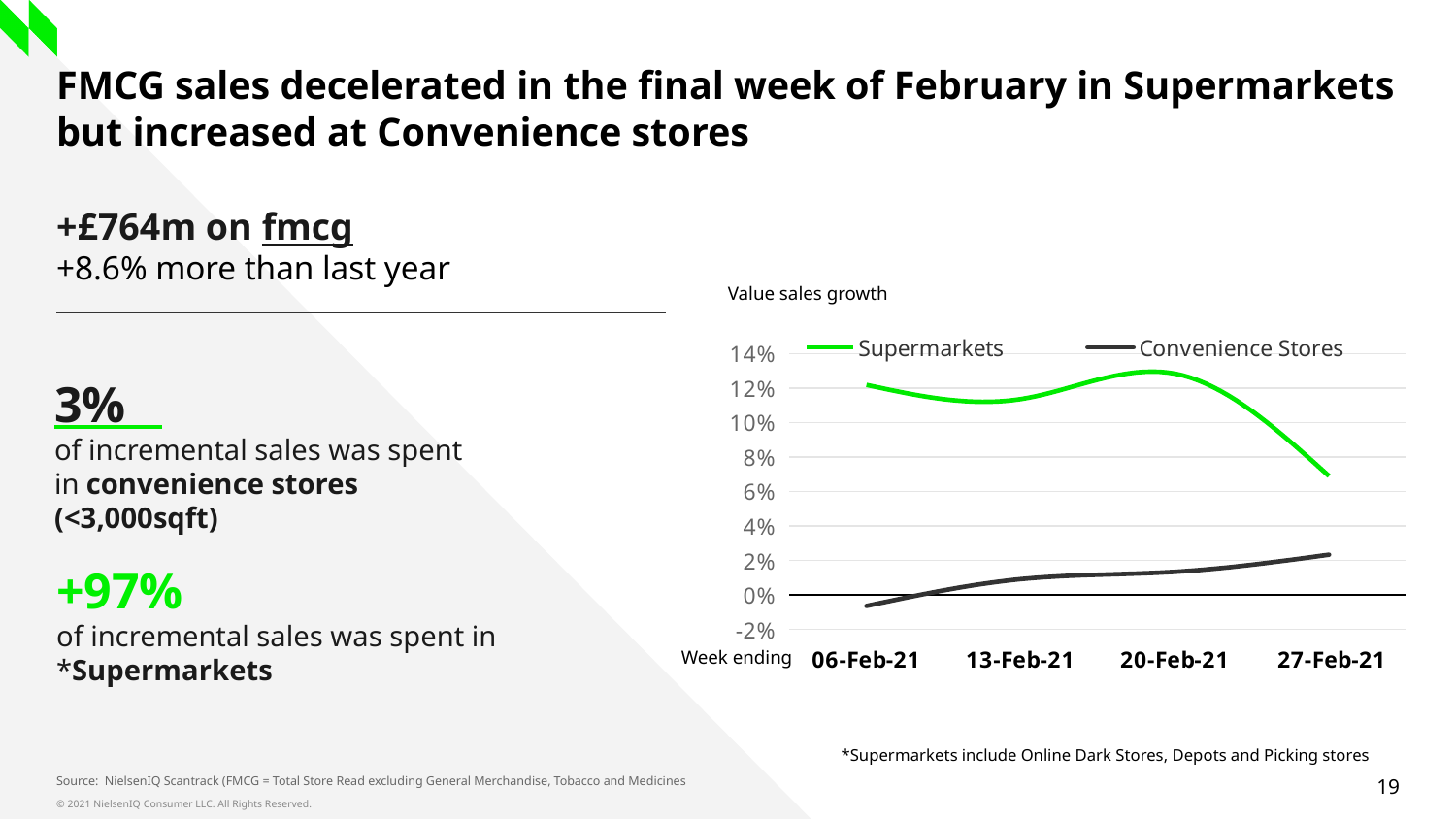
Does the Convenience Stores line rise or fall from 06-Feb-21 to 27-Feb-21? rise For which week ending is the Convenience Stores value highest? 27-Feb-21 How many week-ending dates are plotted on the x axis of the chart? 4 Is the Convenience Stores value for the week ending 06-Feb-21 greater or less than 0%? less What is the title of the chart? Value sales growth Is the Convenience Stores value for the week ending 27-Feb-21 greater or less than 4%? less Is the Supermarkets value for the week ending 27-Feb-21 greater or less than 10%? less For which week ending is the Supermarkets value lowest? 27-Feb-21 How many series does the chart legend list? 2 Which series is drawn in green in the chart? Supermarkets What kind of chart is shown on the slide? line chart